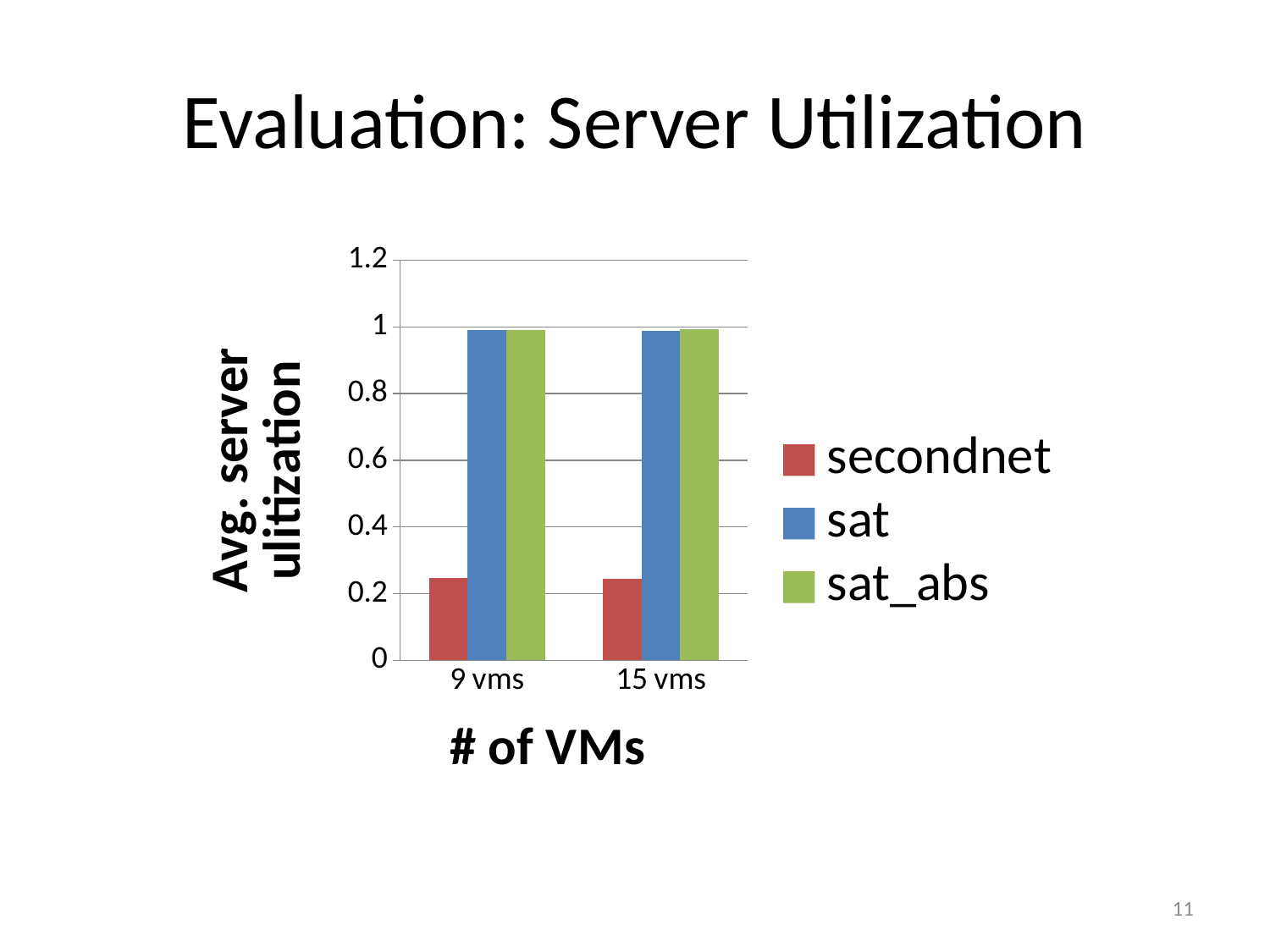
Is the value for secondnet at 9 vms greater or less than 0.4? less Is the value for secondnet at 15 vms greater or less than 0.2? greater What kind of chart is shown on the slide? bar chart How many categories are shown on the x axis? 2 Is the value for sat_abs at 9 vms greater or less than 0.6? greater What is the title of the x axis? # of VMs What is the title of the y axis? Avg. server ulitization How many series does the legend list? 3 Which is larger at 9 vms: secondnet or sat? sat Which series has the lowest value for 9 vms? secondnet Which series has the lowest value for 15 vms? secondnet